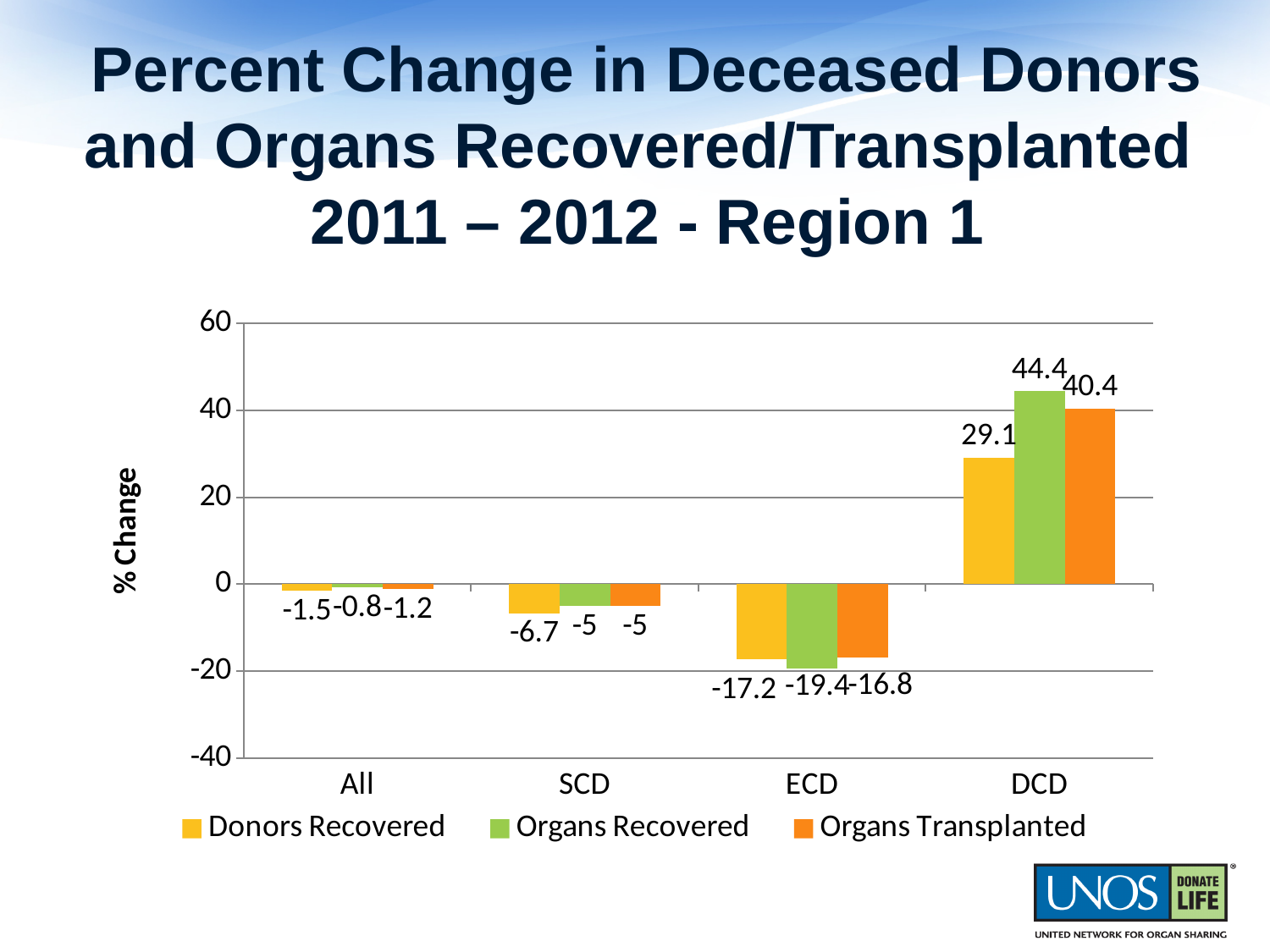
What is the value for Organs Recovered in the ECD category? -19.4 What kind of chart is shown on the slide? Bar chart Which category has the lowest value for Organs Transplanted? ECD How many categories are shown on the x axis? 4 What is the value for Donors Recovered in the SCD category? -6.7 What is the difference between Organs Recovered and Organs Transplanted in the DCD category? 4 What is the label of the y axis? % Change What is the value for Donors Recovered in the DCD category? 29.1 How many series does the legend list? 3 Which is larger in the DCD category: Donors Recovered or Organs Transplanted? Organs Transplanted What is the value for Organs Transplanted in the All category? -1.2 Which category has the highest value for Organs Recovered? DCD